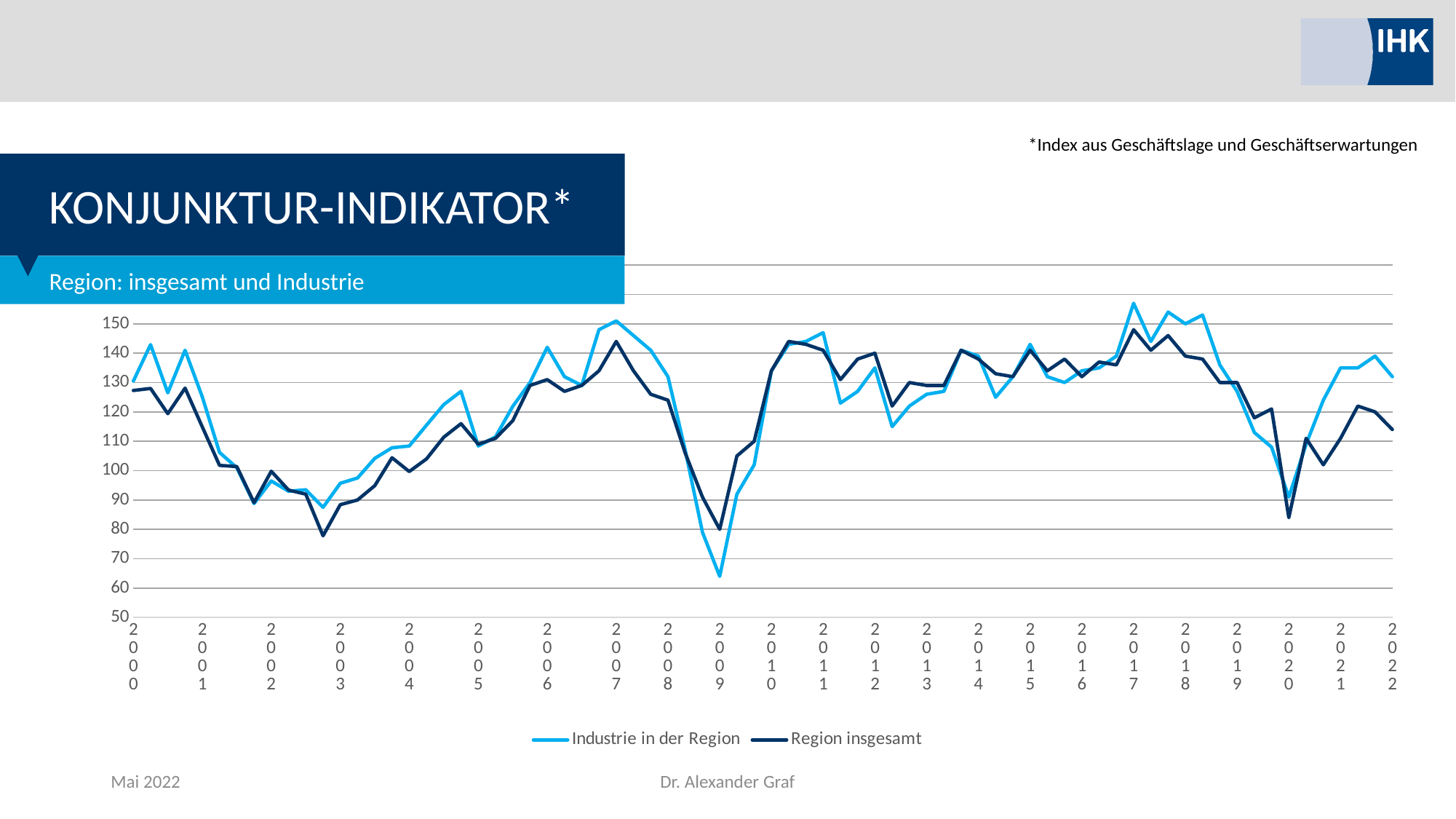
Does the Industrie in der Region series rise or fall from 2000 to 2003? fall Which two series are listed in the legend? Industrie in der Region and Region insgesamt Is the value for Region insgesamt in 2022 greater or less than 120? less How many years are labelled on the x axis? 23 Is the value for Industrie in der Region in 2017 greater or less than 150? greater In 2009, which series has the higher value, Industrie in der Region or Region insgesamt? Region insgesamt How many series does the legend list? 2 In which year does the Industrie in der Region series reach its lowest value? 2009 In which year does the Industrie in der Region series reach its highest value? 2017 What kind of chart is shown on the slide? line chart Is the value for Industrie in der Region in 2009 greater or less than 70? less